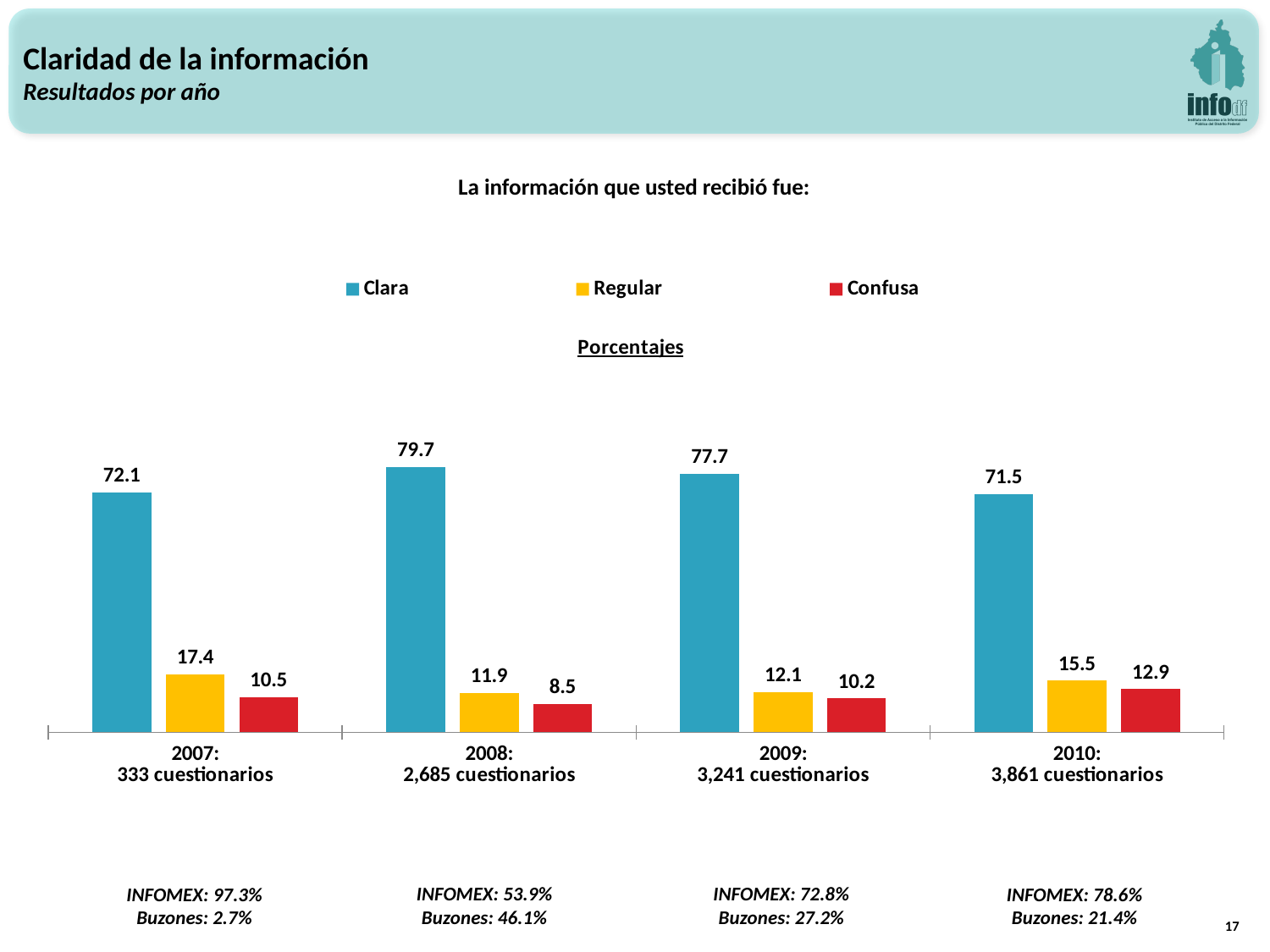
How many year categories are shown on the x axis? 4 What kind of chart is shown on the slide? bar chart How many series does the legend list? 3 What is the value for Regular in 2007? 17.4 Does the Clara value rise or fall from 2009 to 2010? fall Which is larger, the Regular value in 2009 or the Confusa value in 2009? Regular What is the difference between the Clara values for 2008 and 2010? 8.2 Which colour represents the Regular series in the legend? yellow What is the value for Confusa in 2010? 12.9 In which year is the Clara value highest? 2008 In which year is the Confusa value lowest? 2008 What is the value for Clara in 2008? 79.7